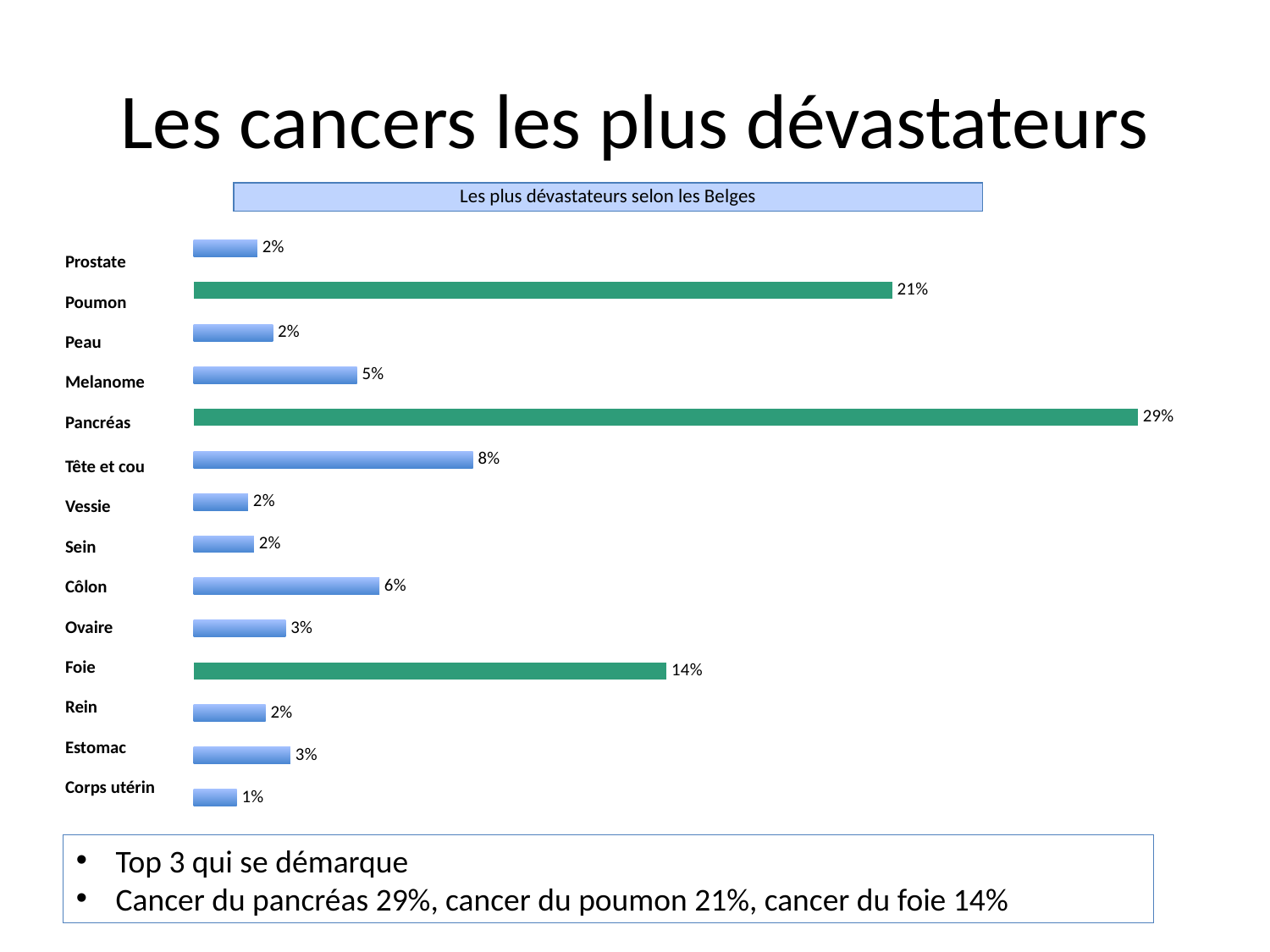
Which category has the lowest value? Corps utérin What is the difference between the values for Pancréas and Poumon? 8% What is the value for Tête et cou? 8% What kind of chart is shown on the slide? Bar chart What is the title of the chart? Les plus dévastateurs selon les Belges Which is larger, the value for Tête et cou or the value for Côlon? Tête et cou How many categories are shown in the chart? 14 What is the difference between the values for Foie and Melanome? 9% What is the value for Pancréas? 29% What is the value for Côlon? 6% What is the value for Poumon? 21% Which category has the highest value? Pancréas